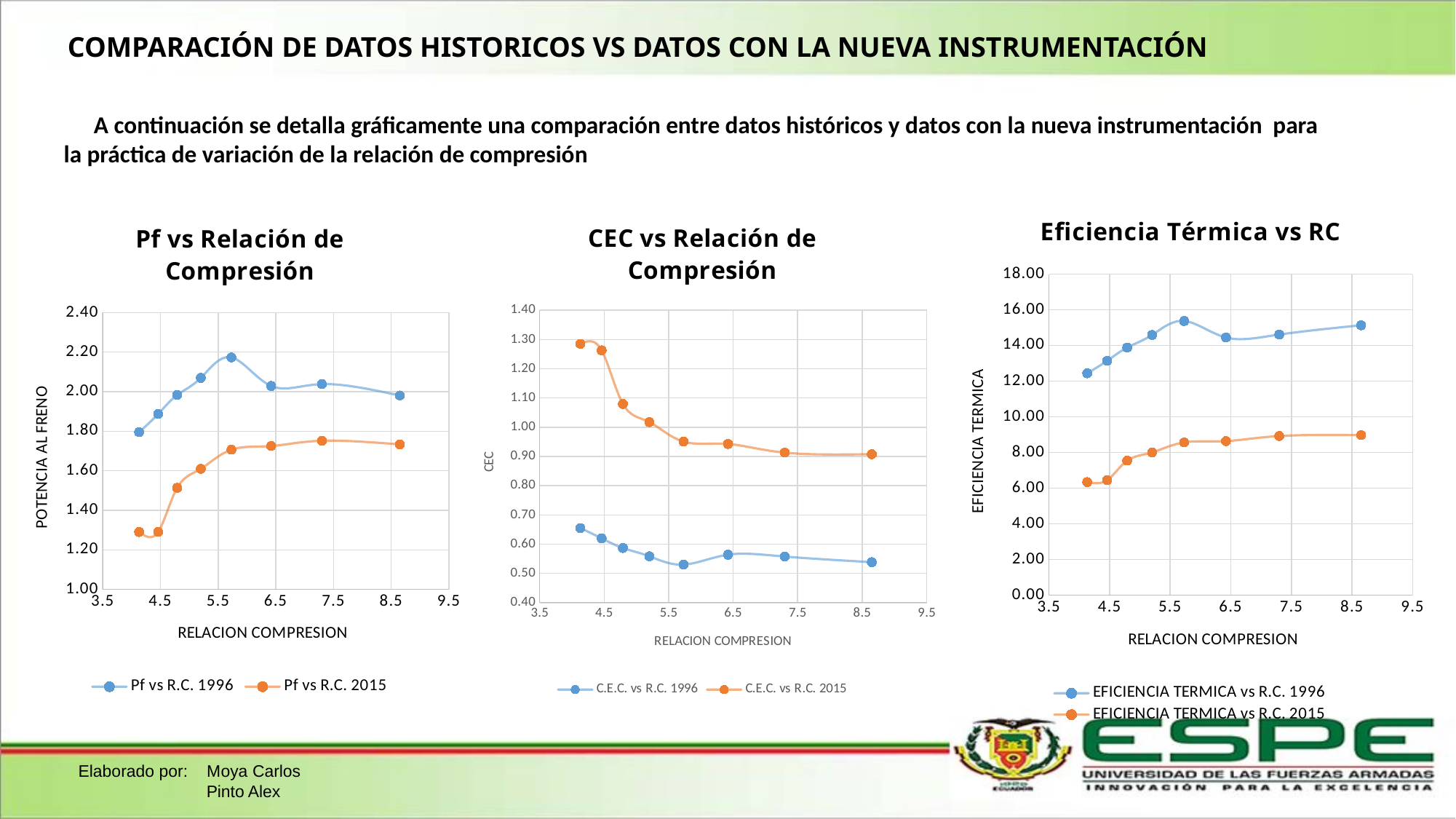
In the 'Pf vs Relación de Compresión' chart, which series has the higher values, 'Pf vs R.C. 1996' or 'Pf vs R.C. 2015'? Pf vs R.C. 1996 In the 'Eficiencia Térmica vs RC' chart, is the highest value of the 'EFICIENCIA TERMICA vs R.C. 1996' series greater or less than 14.00? greater What is the y-axis label of the 'Pf vs Relación de Compresión' chart? POTENCIA AL FRENO In the 'CEC vs Relación de Compresión' chart, which series has the higher values, 'C.E.C. vs R.C. 1996' or 'C.E.C. vs R.C. 2015'? C.E.C. vs R.C. 2015 What is the x-axis label of the 'Eficiencia Térmica vs RC' chart? RELACION COMPRESION How many series does the legend of the 'CEC vs Relación de Compresión' chart list? 2 In the 'Eficiencia Térmica vs RC' chart, how many data points does the 'EFICIENCIA TERMICA vs R.C. 1996' series have? 8 In the 'CEC vs Relación de Compresión' chart, is the lowest value of the 'C.E.C. vs R.C. 1996' series greater or less than 0.60? less In the 'Pf vs Relación de Compresión' chart, is the highest value of the 'Pf vs R.C. 1996' series greater or less than 2.00? greater In the 'CEC vs Relación de Compresión' chart, do the values of the 'C.E.C. vs R.C. 2015' series rise or fall as the compression ratio increases? fall What type of chart is the 'Pf vs Relación de Compresión' chart? line chart In the 'Eficiencia Térmica vs RC' chart, do the values of the 'EFICIENCIA TERMICA vs R.C. 2015' series generally rise or fall along the x axis? rise